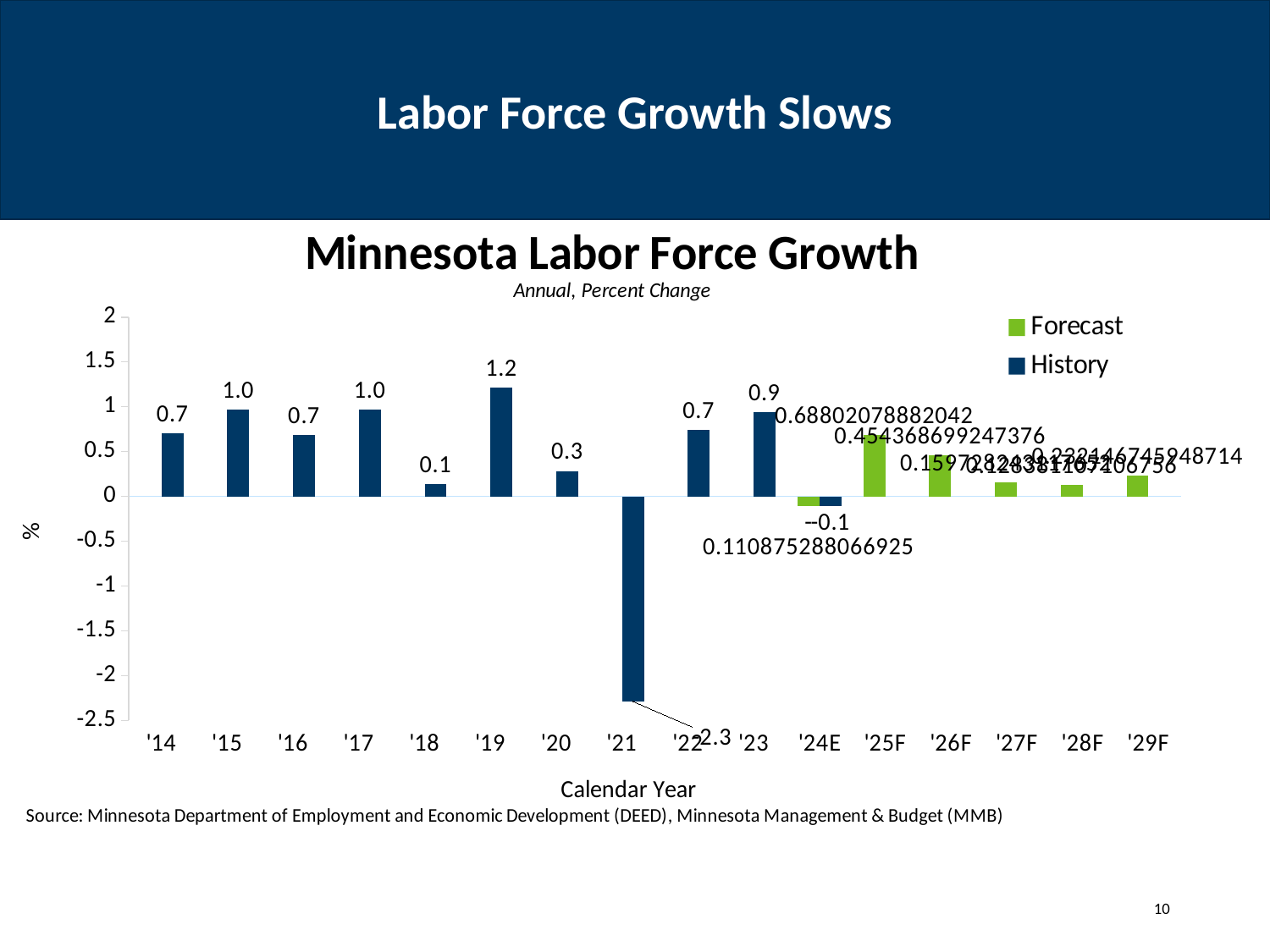
Which year has the highest labor force growth? '19 What kind of chart is shown on the slide? bar chart What is the labor force growth value for '19? 1.2 What is the title of the x axis? Calendar Year What is the labor force growth value for '21? -2.3 What is the difference between the values for '19 and '18? 1.1 Which is larger, the value for '15 or the value for '16? '15 How many series does the legend list? 2 Which year has the lowest labor force growth? '21 How many years are shown on the x axis? 16 What is the labor force growth value for '20? 0.3 Is the value for '25F greater or less than 1? less